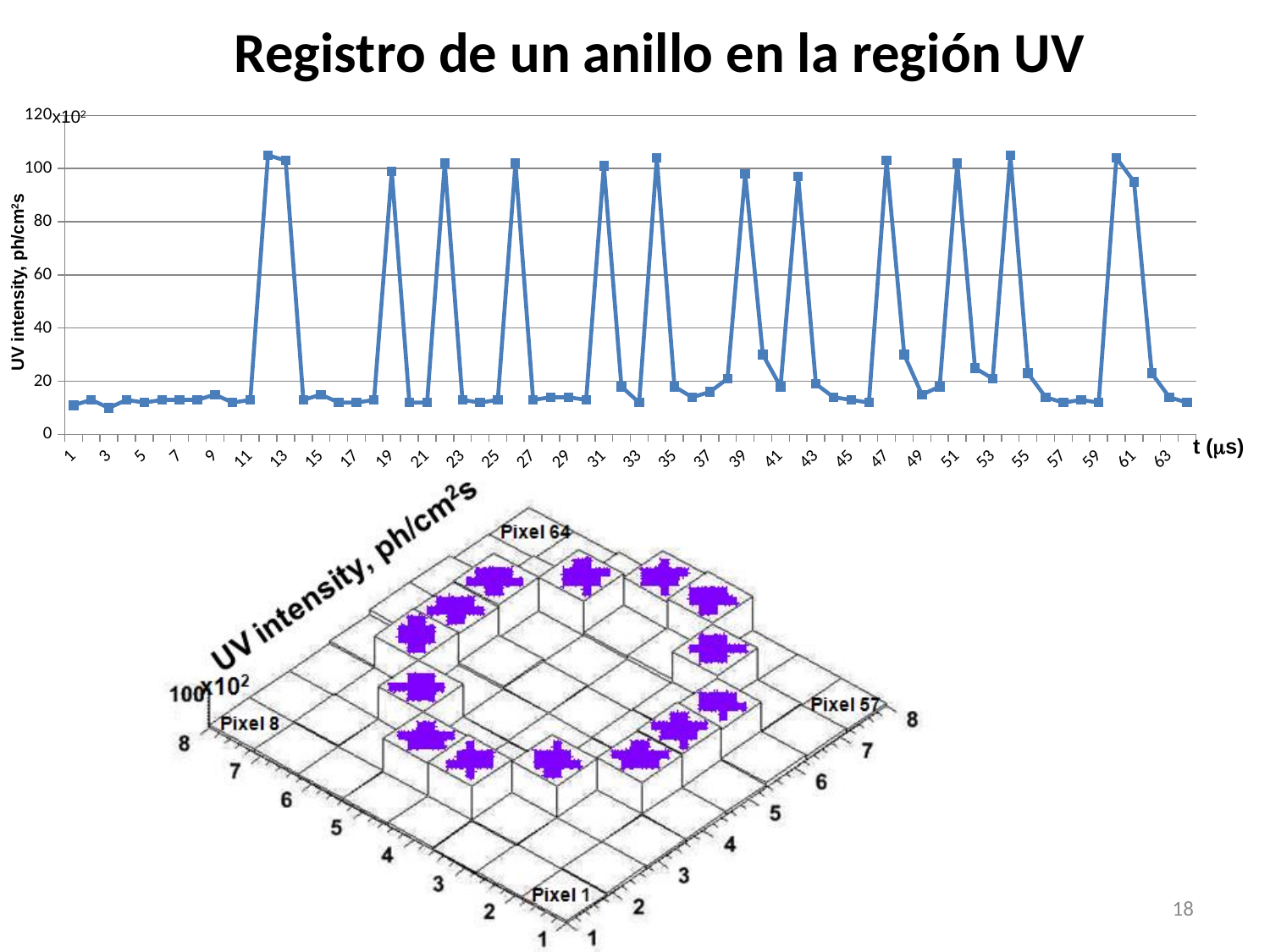
In the top chart, does the value rise or fall from t = 11 to t = 12? rise In the top chart, which is larger, the value at t = 12 or the value at t = 14? t = 12 In the top chart, is the value at t = 12 greater or less than 100? greater What kind of chart is the top chart on the slide? line chart In the top chart, does the value rise or fall from t = 13 to t = 14? fall What is the label of the vertical axis of the top chart? UV intensity, ph/cm²s In the top chart, is the value at t = 1 greater or less than 20? less In the top chart, is the value at t = 40 greater or less than 20? greater How many data series are plotted in the top chart? 1